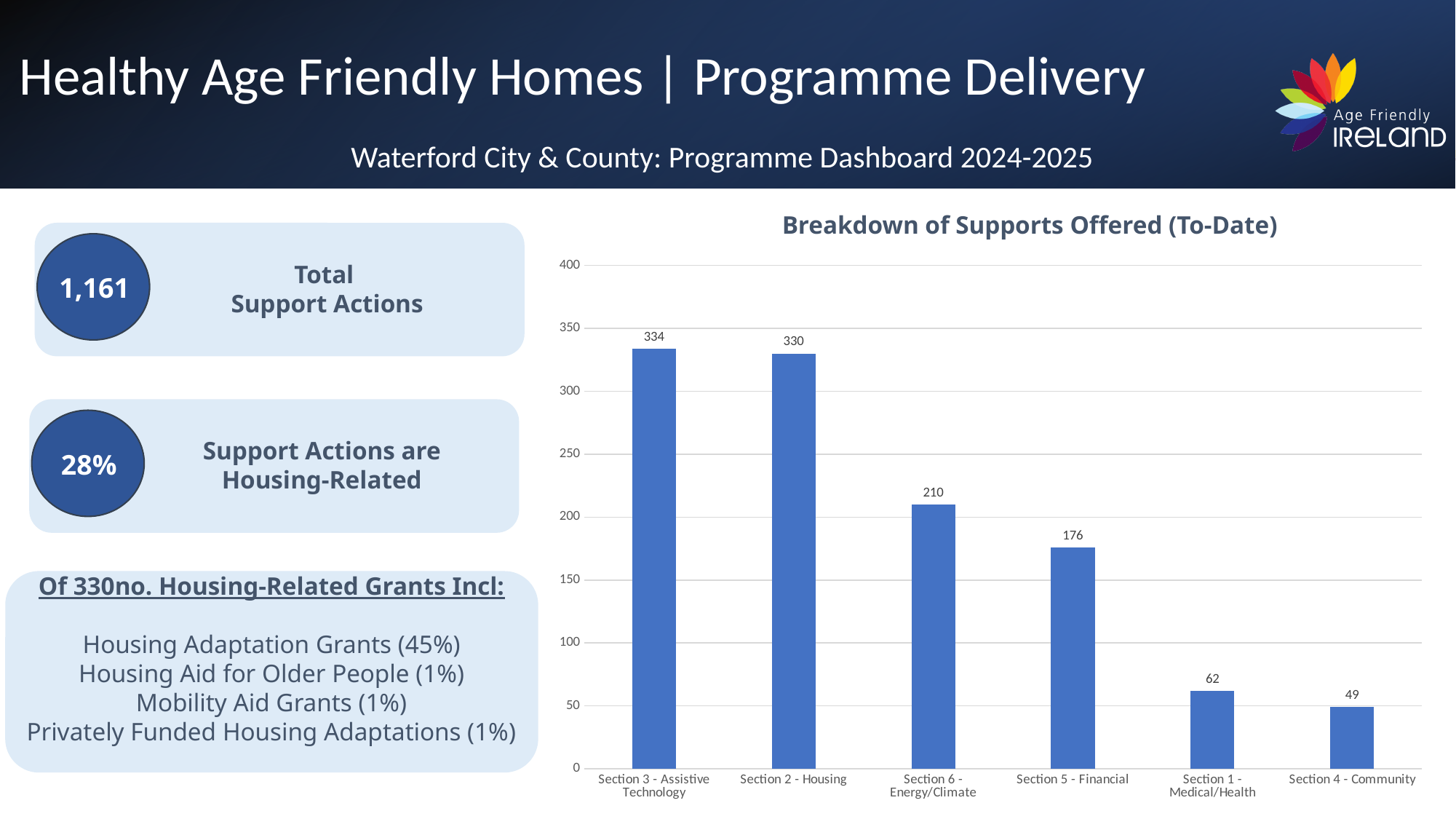
Is the value for Section 5 - Financial greater or less than 150? greater What is the difference between the values for Section 2 - Housing and Section 5 - Financial? 154 What is the value for Section 1 - Medical/Health? 62 Which category has the highest value? Section 3 - Assistive Technology What kind of chart is shown on the slide? bar chart Which category has the lowest value? Section 4 - Community What is the value for Section 3 - Assistive Technology? 334 What is the difference between the values for Section 1 - Medical/Health and Section 4 - Community? 13 Which is larger, the value for Section 6 - Energy/Climate or the value for Section 5 - Financial? Section 6 - Energy/Climate What is the value for Section 6 - Energy/Climate? 210 How many categories are shown on the x axis? 6 What is the title of the chart? Breakdown of Supports Offered (To-Date)